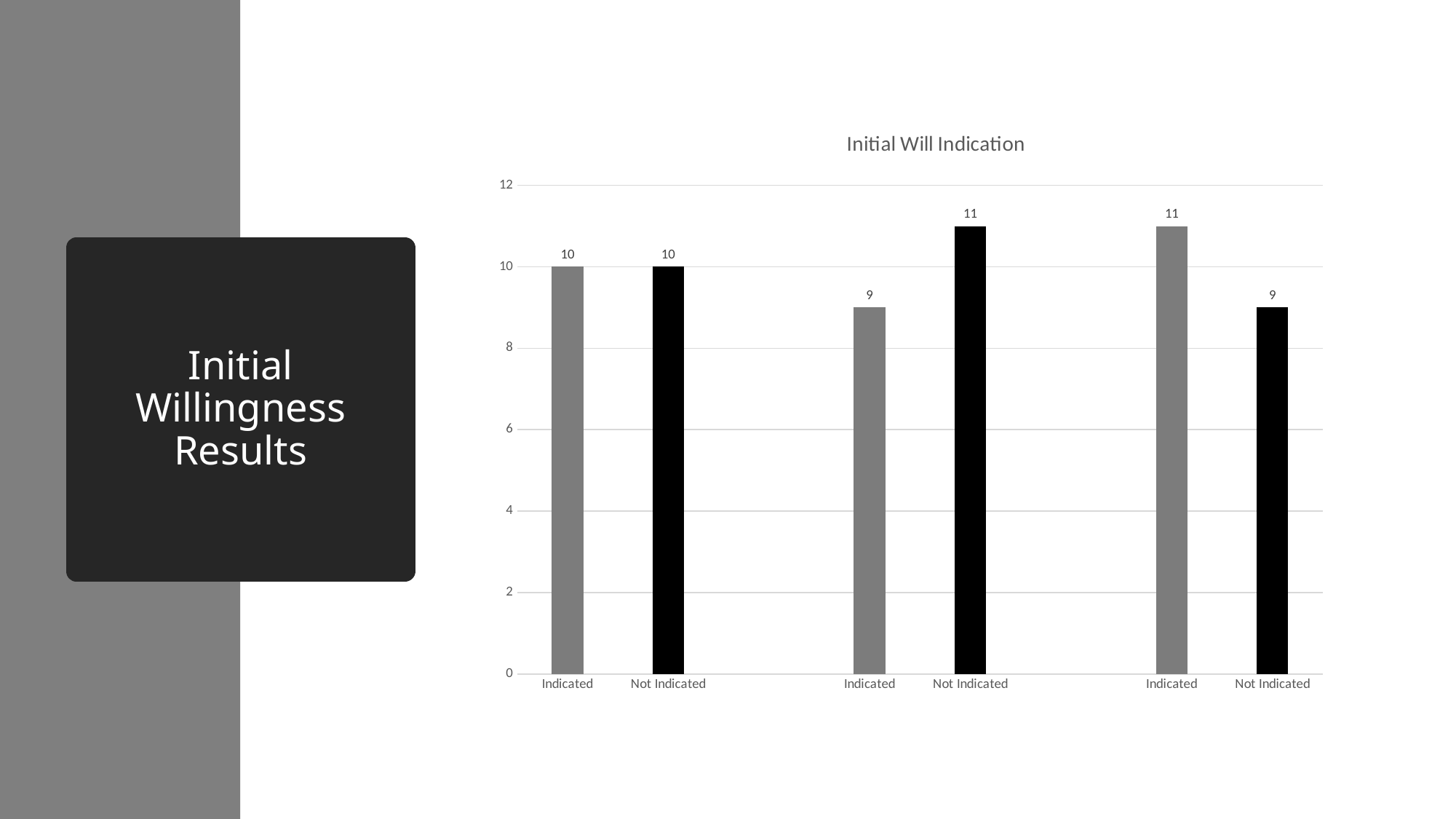
In the middle group, what is the difference between the Not Indicated and Indicated values? 2 What kind of chart is shown on the slide? Bar chart What is the lowest value shown in the chart? 9 What is the title of the chart? Initial Will Indication What is the value of the Not Indicated bar in the middle group? 11 How many bars are plotted in the chart? 6 What is the value of the Not Indicated bar in the rightmost group? 9 In the rightmost group, which bar is larger, Indicated or Not Indicated? Indicated What is the value of the Indicated bar in the rightmost group? 11 Is the value for Not Indicated in the middle group greater or less than 10? greater What is the value of the Indicated bar in the leftmost group? 10 What is the highest value shown in the chart? 11